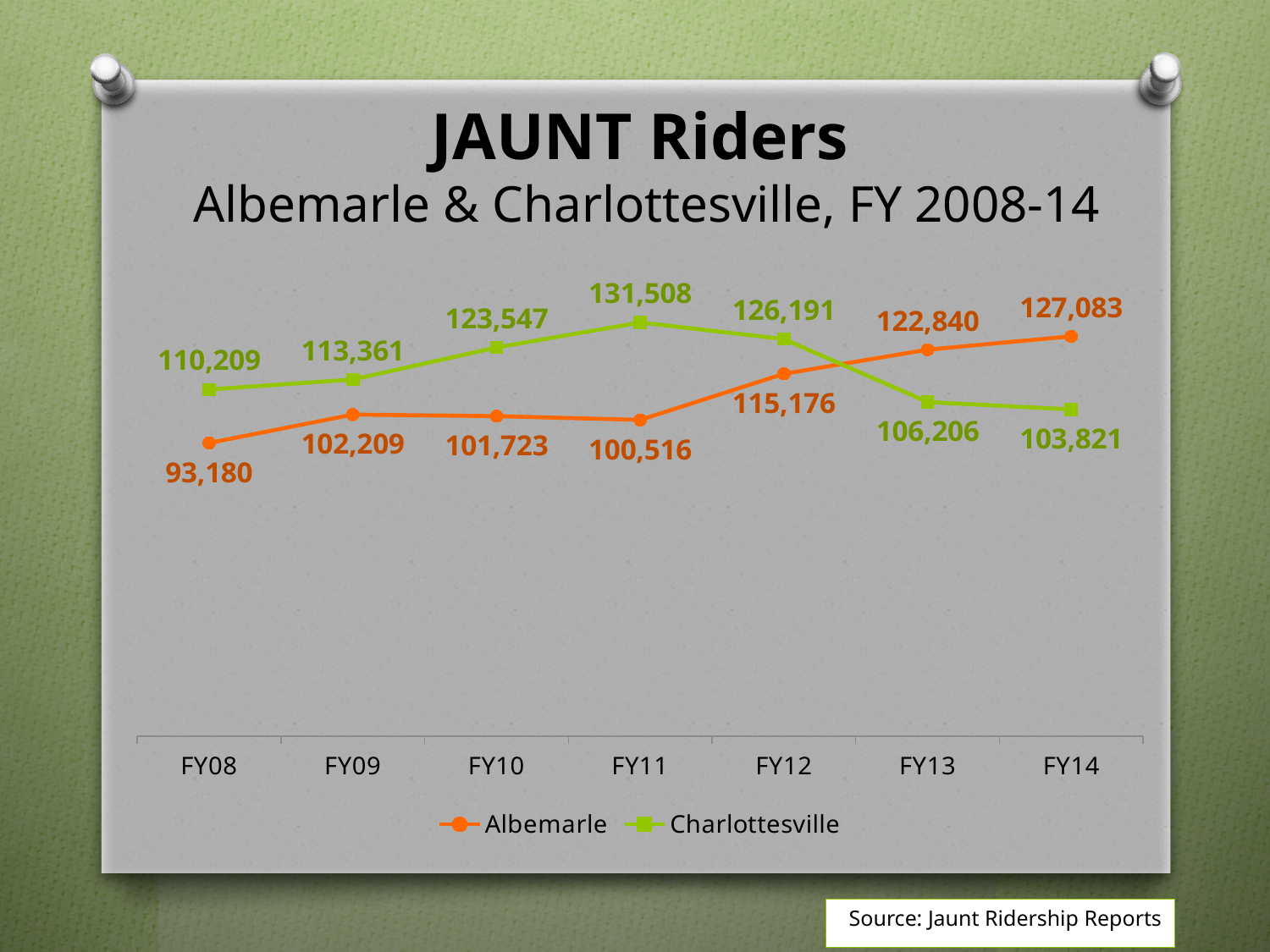
How many fiscal years are shown on the x axis? 7 What kind of chart is shown on the slide? Line chart What was the Albemarle ridership in FY08? 93,180 In FY13, which had more riders, Albemarle or Charlottesville? Albemarle What is the difference between Albemarle and Charlottesville ridership in FY14? 23,262 How many series does the legend list? 2 In which fiscal year was Albemarle ridership lowest? FY08 What was the Charlottesville ridership in FY11? 131,508 In which fiscal year did Charlottesville ridership peak? FY11 By how much did Albemarle ridership grow from FY08 to FY14? 33,903 What was the Albemarle ridership in FY12? 115,176 What was the Charlottesville ridership in FY14? 103,821